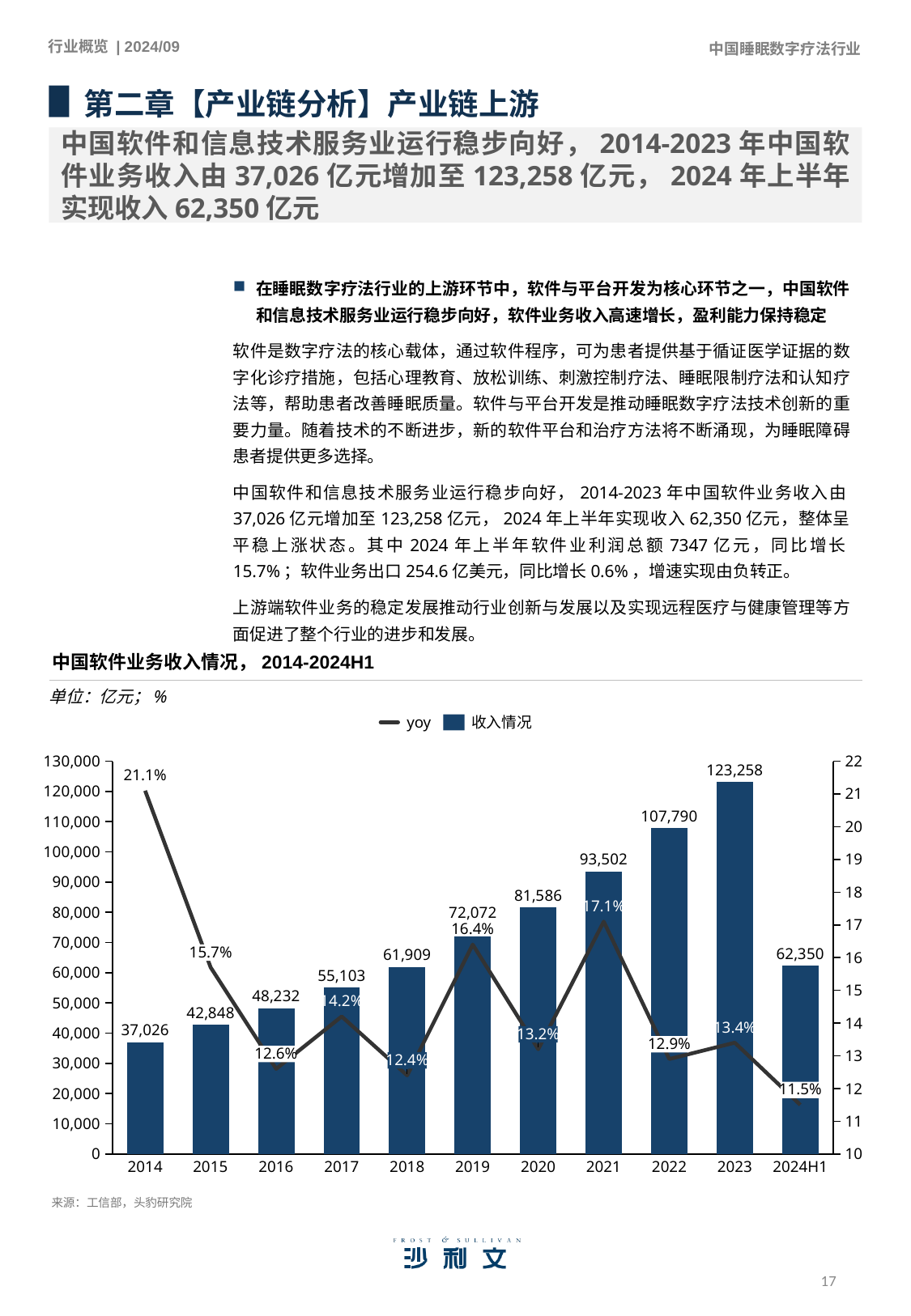
How many series does the legend list? 2 Which year has the highest 收入情况 value? 2023 How many categories are shown on the x axis? 11 What is the difference between the 收入情况 values for 2023 and 2014? 86,232 What is the yoy value for 2021? 17.1% Which is larger, the yoy value for 2019 or for 2020? 2019 What is the 收入情况 value for 2024H1? 62,350 What is the 收入情况 value for 2023? 123,258 Do the 收入情况 values rise or fall from 2014 to 2023? rise Which category has the lowest yoy value? 2024H1 What kind of chart is used to show the 收入情况 series? bar chart What is the yoy value for 2014? 21.1%